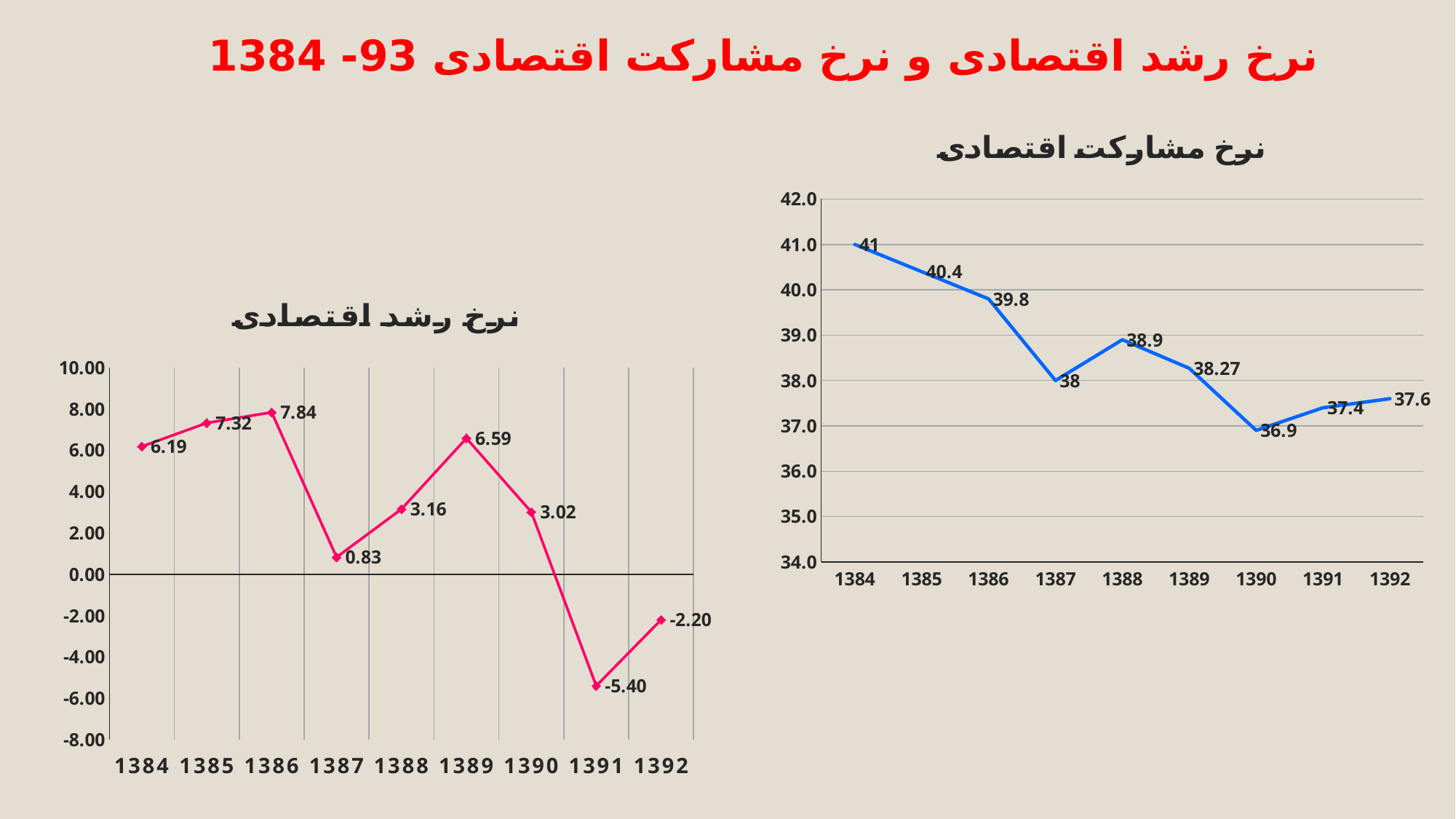
In the left chart (نرخ رشد اقتصادی), which is larger, the value for 1388 or the value for 1390? 1388 In the left chart (نرخ رشد اقتصادی), what is the value for 1386? 7.84 In the left chart (نرخ رشد اقتصادی), what is the value for 1391? -5.40 In the left chart (نرخ رشد اقتصادی), what is the difference between the values for 1386 and 1387? 7.01 In the left chart (نرخ رشد اقتصادی), which year has the lowest value? 1391 In the right chart (نرخ مشارکت اقتصادی), what is the value for 1389? 38.27 What kind of chart is the left chart (نرخ رشد اقتصادی)? line chart In the right chart (نرخ مشارکت اقتصادی), which year has the highest value? 1384 In the right chart (نرخ مشارکت اقتصادی), which year has the lowest value? 1390 In the right chart (نرخ مشارکت اقتصادی), what is the difference between the values for 1384 and 1392? 3.4 How many years are plotted in the right chart (نرخ مشارکت اقتصادی)? 9 In the right chart (نرخ مشارکت اقتصادی), do the values generally rise or fall from 1384 to 1392? fall